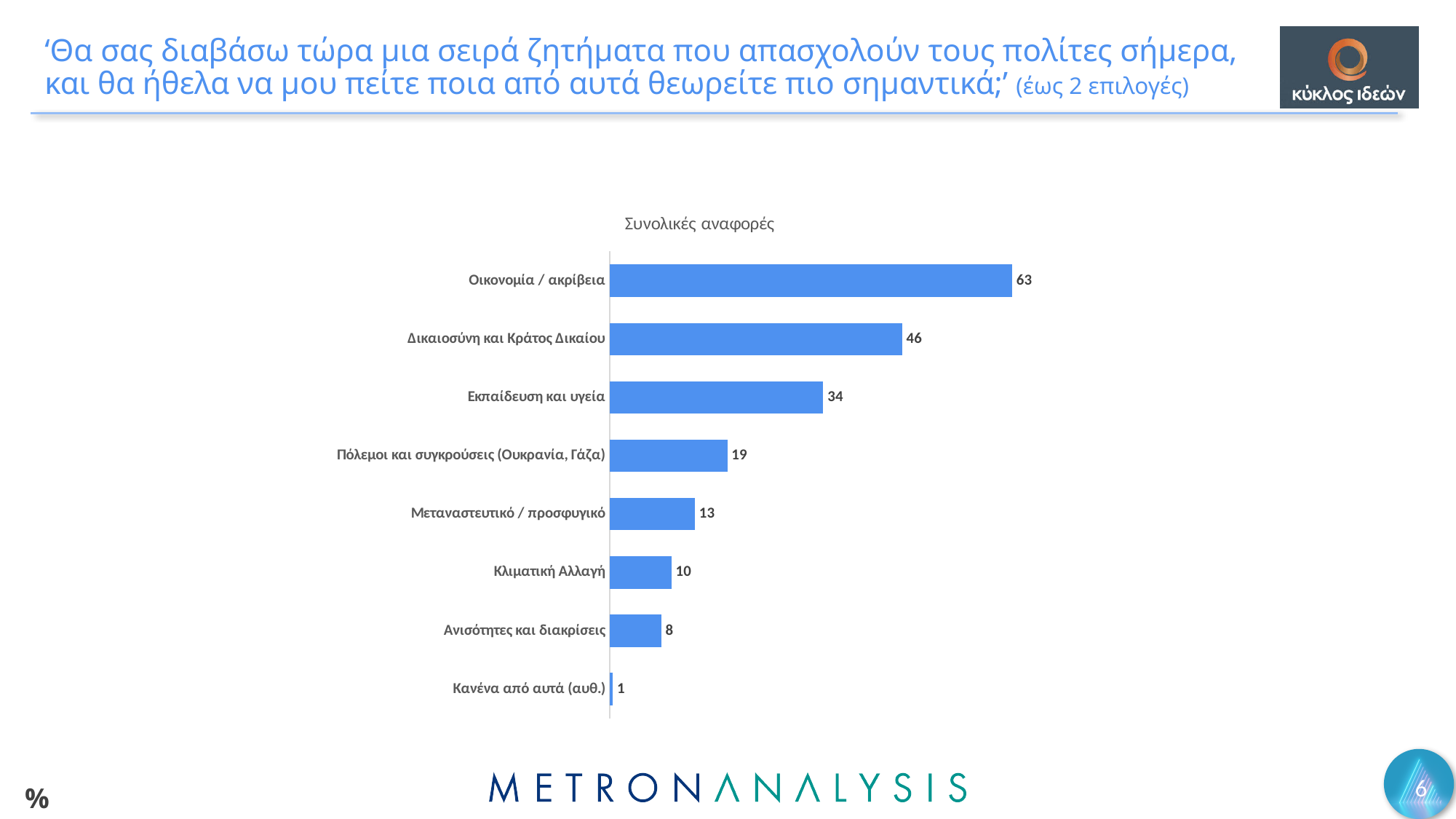
What is the value for Δικαιοσύνη και Κράτος Δικαίου? 46 What kind of chart is shown on the slide? Bar chart What is the value for Οικονομία / ακρίβεια? 63 What is the value for Κανένα από αυτά (αυθ.)? 1 Which category has the lowest value? Κανένα από αυτά (αυθ.) Which category has the highest value? Οικονομία / ακρίβεια What is the difference between the values for Οικονομία / ακρίβεια and Δικαιοσύνη και Κράτος Δικαίου? 17 What is the difference between the values for Εκπαίδευση και υγεία and Πόλεμοι και συγκρούσεις (Ουκρανία, Γάζα)? 15 How many categories are shown in the chart? 8 Which is larger, the value for Κλιματική Αλλαγή or the value for Ανισότητες και διακρίσεις? Κλιματική Αλλαγή What is the value for Μεταναστευτικό / προσφυγικό? 13 What is the title of the chart? Συνολικές αναφορές